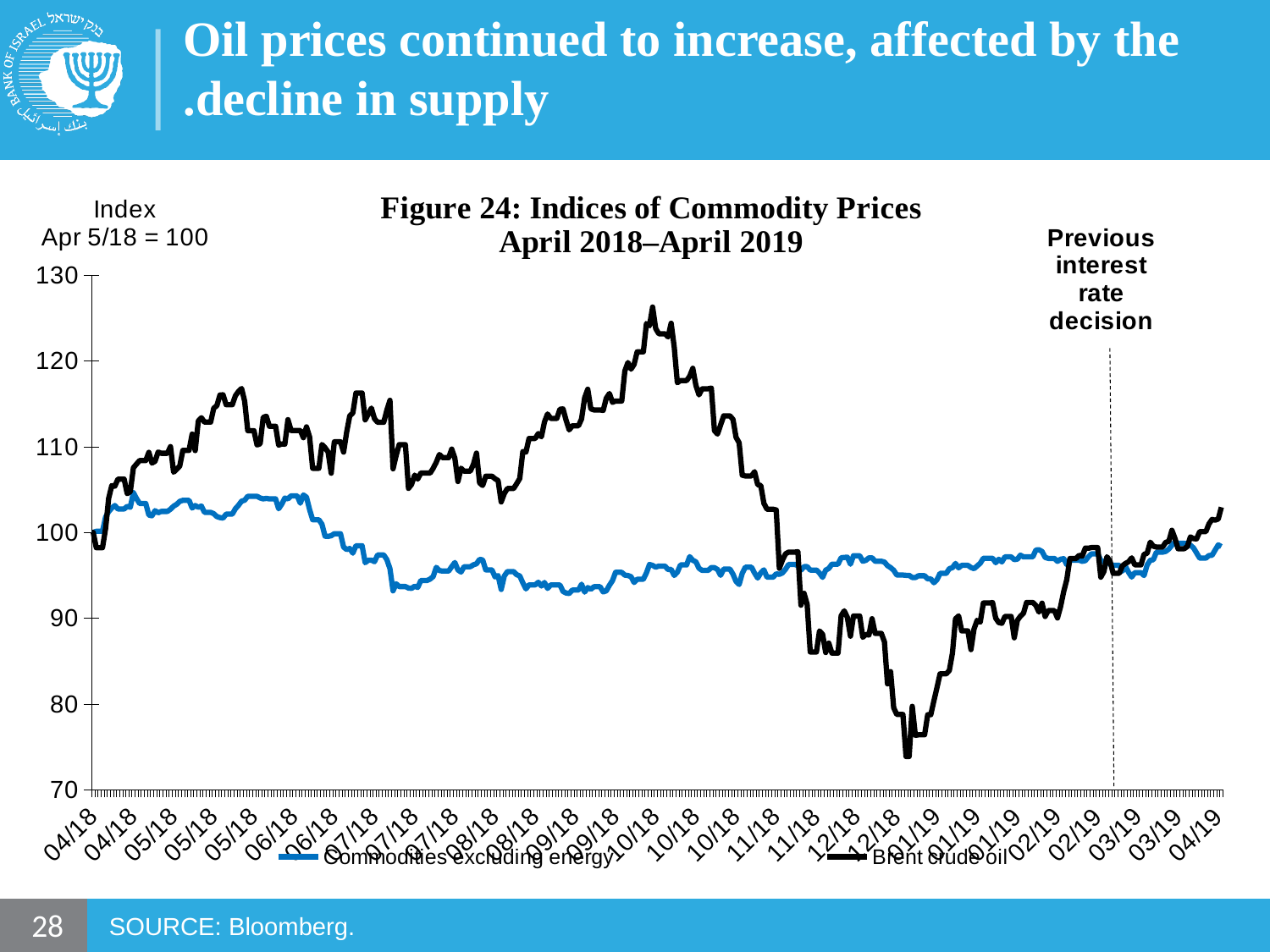
Does Brent crude oil rise or fall between 10/18 and 12/18? fall What kind of chart is shown in Figure 24? line chart Which series reaches the highest value on the chart? Brent crude oil Is the value of Commodities excluding energy at the end of the period (04/19) greater or less than 100? less What is the title of the chart on the slide? Figure 24: Indices of Commodity Prices April 2018–April 2019 Is the peak value of Brent crude oil around 10/18 greater or less than 120? greater How many series does the legend of Figure 24 list? 2 Around 12/18, which series is higher: Brent crude oil or Commodities excluding energy? Commodities excluding energy Is the lowest value of Brent crude oil around 12/18 greater or less than 80? less Which series is drawn in black in Figure 24? Brent crude oil Which series falls to the lowest value on the chart? Brent crude oil